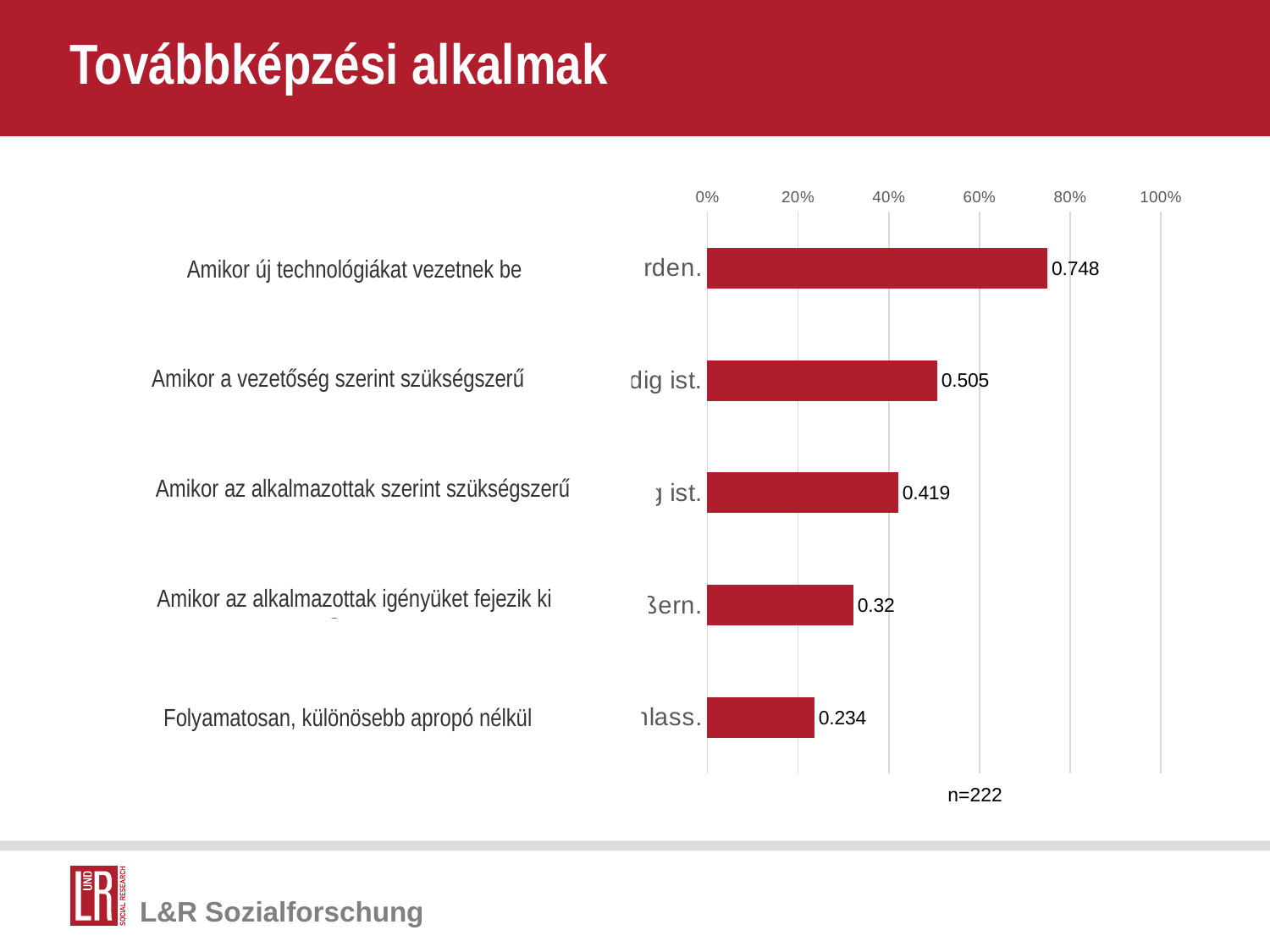
What sample size (n) is noted below the chart? n=222 What kind of chart is shown on the slide? Bar chart How many categories are shown in the chart? 5 What is the difference between the values for "Amikor új technológiákat vezetnek be" and "Amikor a vezetőség szerint szükségszerű"? 0.243 What is the difference between the values for "Amikor az alkalmazottak igényüket fejezik ki" and "Folyamatosan, különösebb apropó nélkül"? 0.086 Which category has the lowest value? Folyamatosan, különösebb apropó nélkül What is the value shown for "Amikor az alkalmazottak szerint szükségszerű"? 0.419 Which is larger: the value for "Amikor az alkalmazottak szerint szükségszerű" or for "Amikor az alkalmazottak igényüket fejezik ki"? Amikor az alkalmazottak szerint szükségszerű Which category has the highest value? Amikor új technológiákat vezetnek be What is the value shown for "Folyamatosan, különösebb apropó nélkül"? 0.234 What is the value shown for "Amikor a vezetőség szerint szükségszerű"? 0.505 What is the value shown for "Amikor új technológiákat vezetnek be"? 0.748